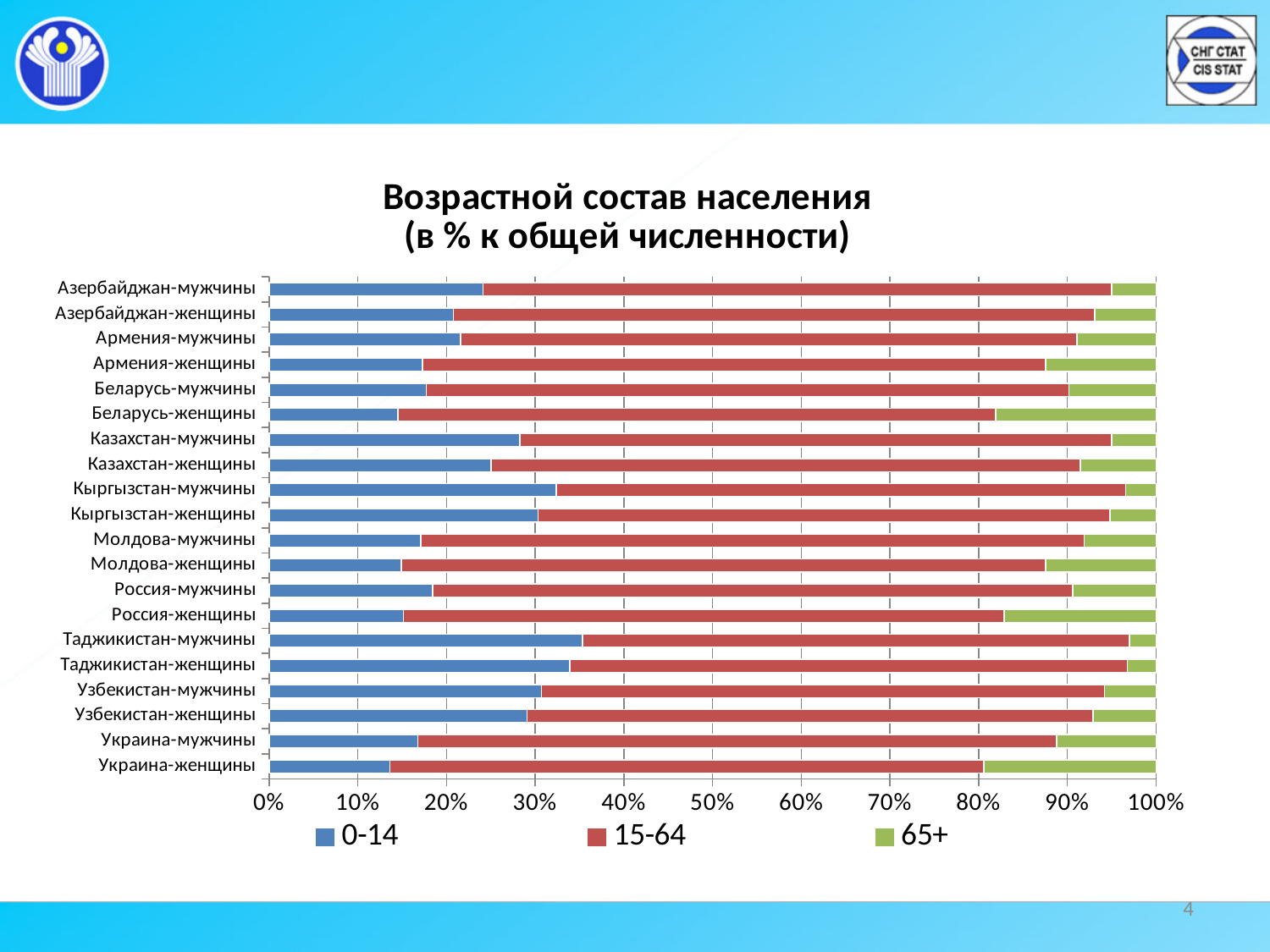
How many series does the legend list? 3 How many categories (country-sex groups) are plotted on the chart? 20 Is the 0-14 share for Таджикистан-мужчины greater or less than 30%? greater Which category has the largest share of the 65+ age group? Украина-женщины Which category has the largest share of the 0-14 age group? Таджикистан-мужчины Is the 0-14 share for Украина-женщины greater or less than 20%? less What kind of chart is shown on the slide? Stacked bar chart What is the title of the chart? Возрастной состав населения (в % к общей численности) Which has a larger 65+ share: Беларусь-женщины or Беларусь-мужчины? Беларусь-женщины What are the three age groups listed in the legend? 0-14, 15-64, 65+ Which has a larger 0-14 share: Казахстан-мужчины or Россия-мужчины? Казахстан-мужчины Which category has the smallest share of the 0-14 age group? Украина-женщины